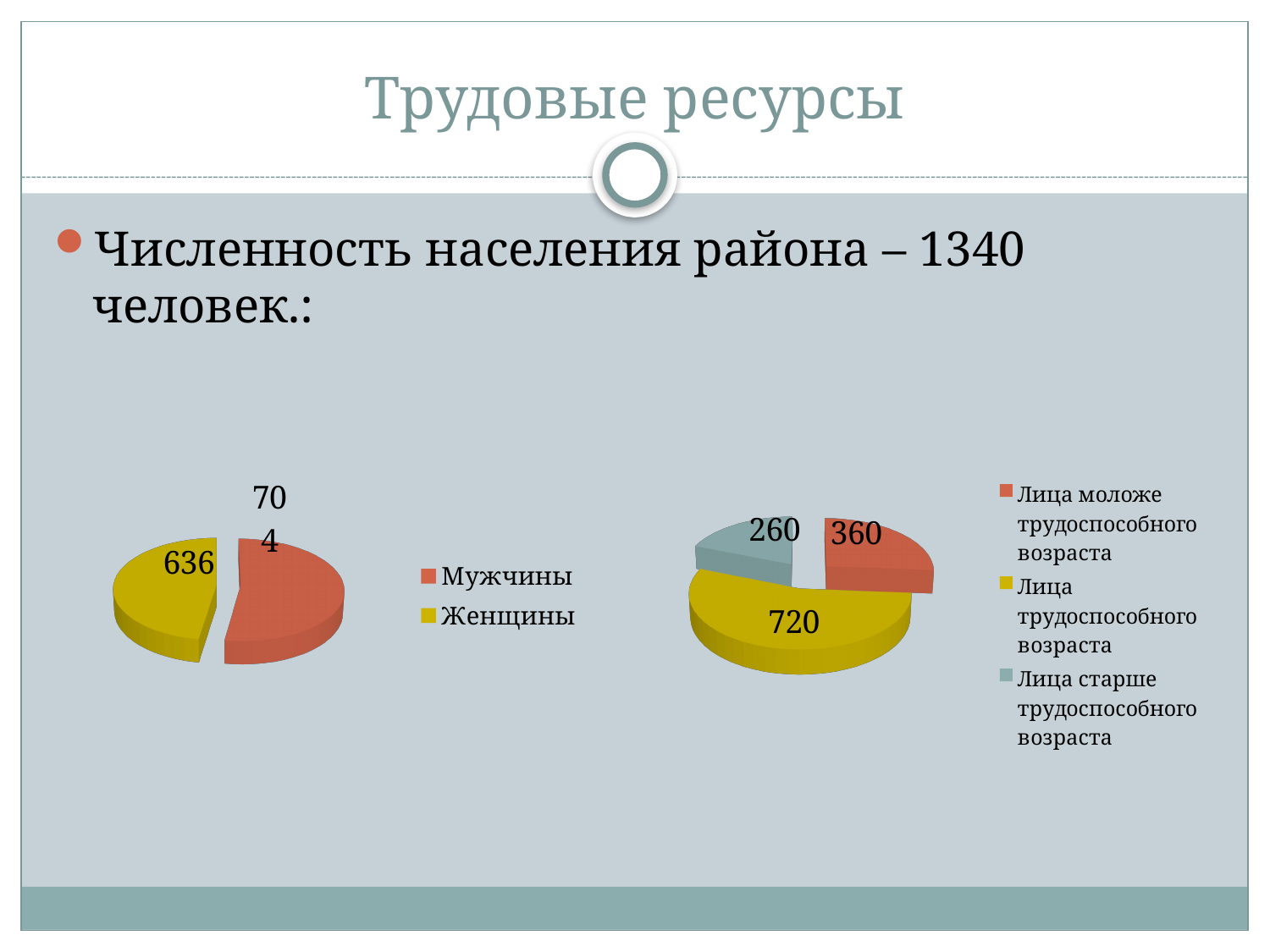
In the left pie chart, what is the value for Мужчины? 704 In the right pie chart, which category has the largest value? Лица трудоспособного возраста What kind of chart is the left chart on the slide? pie chart In the left pie chart, what is the value for Женщины? 636 In the left pie chart, which is larger, Мужчины or Женщины? Мужчины In the right pie chart, what is the difference between the values for Лица трудоспособного возраста and Лица моложе трудоспособного возраста? 360 In the right pie chart, what is the value for Лица трудоспособного возраста? 720 How many entries does the legend of the right pie chart list? 3 In the right pie chart, which category has the smallest value? Лица старше трудоспособного возраста In the right pie chart, what is the value for Лица старше трудоспособного возраста? 260 In the right pie chart, what is the value for Лица моложе трудоспособного возраста? 360 How many slices does the left pie chart have? 2